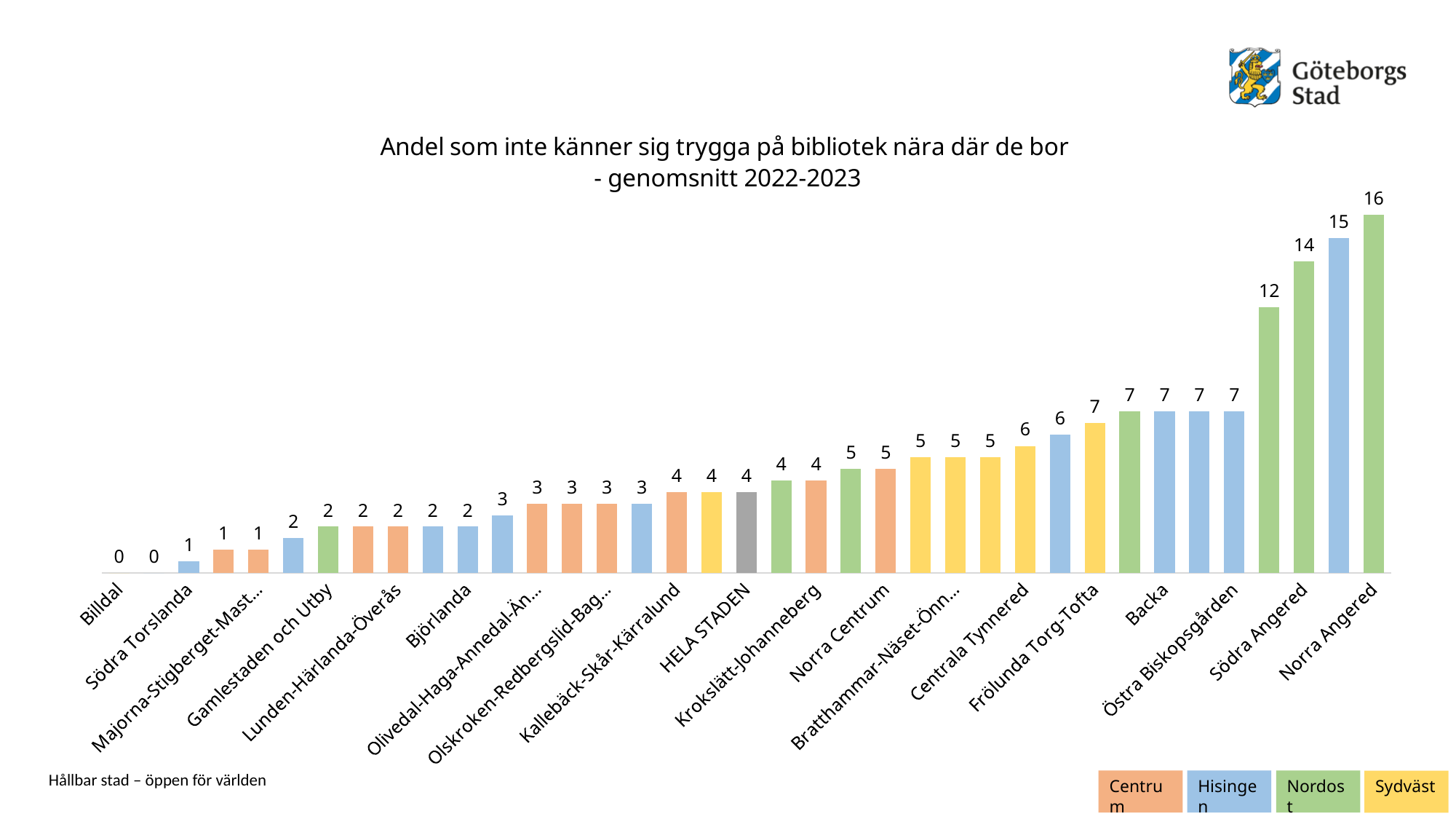
What is the difference between the values for Norra Angered and HELA STADEN? 12 What is the difference between the values for Norra Angered and Södra Angered? 2 What kind of chart is shown? Bar chart What is the value for Centrala Tynnered? 6 What is the value for Södra Angered? 14 What is the value for HELA STADEN? 4 What is the value for Norra Angered? 16 Which area has the highest value? Norra Angered What is the value for Billdal? 0 Do the values rise or fall from left to right along the x axis? Rise Which is larger, the value for Backa or the value for Centrala Tynnered? Backa How many entries does the legend list? 4